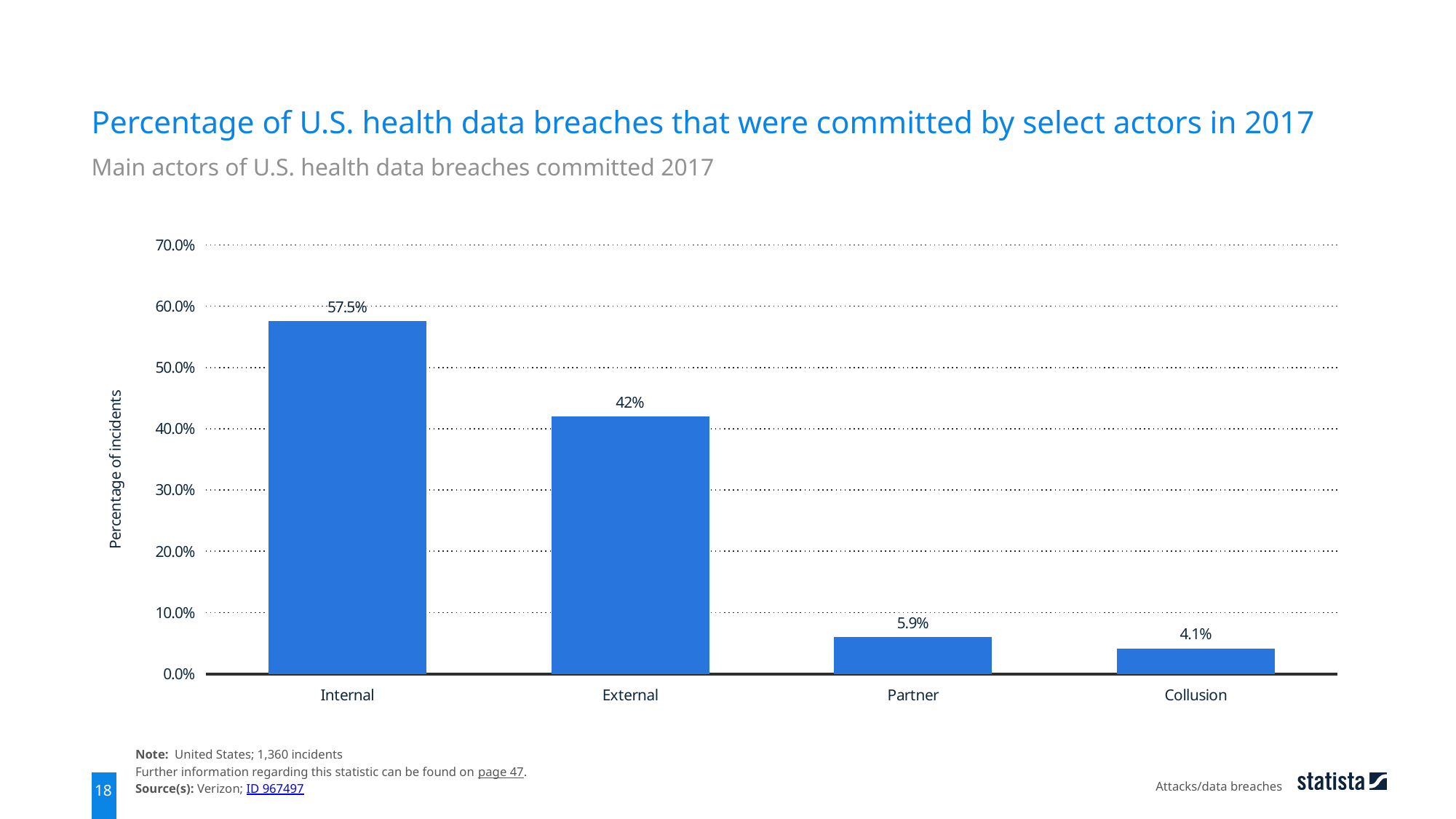
Which has a higher percentage of incidents, Partner or Collusion? Partner What percentage of incidents were committed by Partner actors? 5.9% Is the value for External greater or less than 40.0%? greater What percentage of incidents were committed by Collusion? 4.1% Which actor category has the highest percentage of incidents? Internal What is the difference in percentage points between Internal and External actors? 15.5 How many actor categories are shown on the x axis? 4 What is the label of the y axis? Percentage of incidents What percentage of incidents were committed by Internal actors? 57.5% Which actor category has the lowest percentage of incidents? Collusion What percentage of incidents were committed by External actors? 42% What kind of chart is shown on the slide? Bar chart